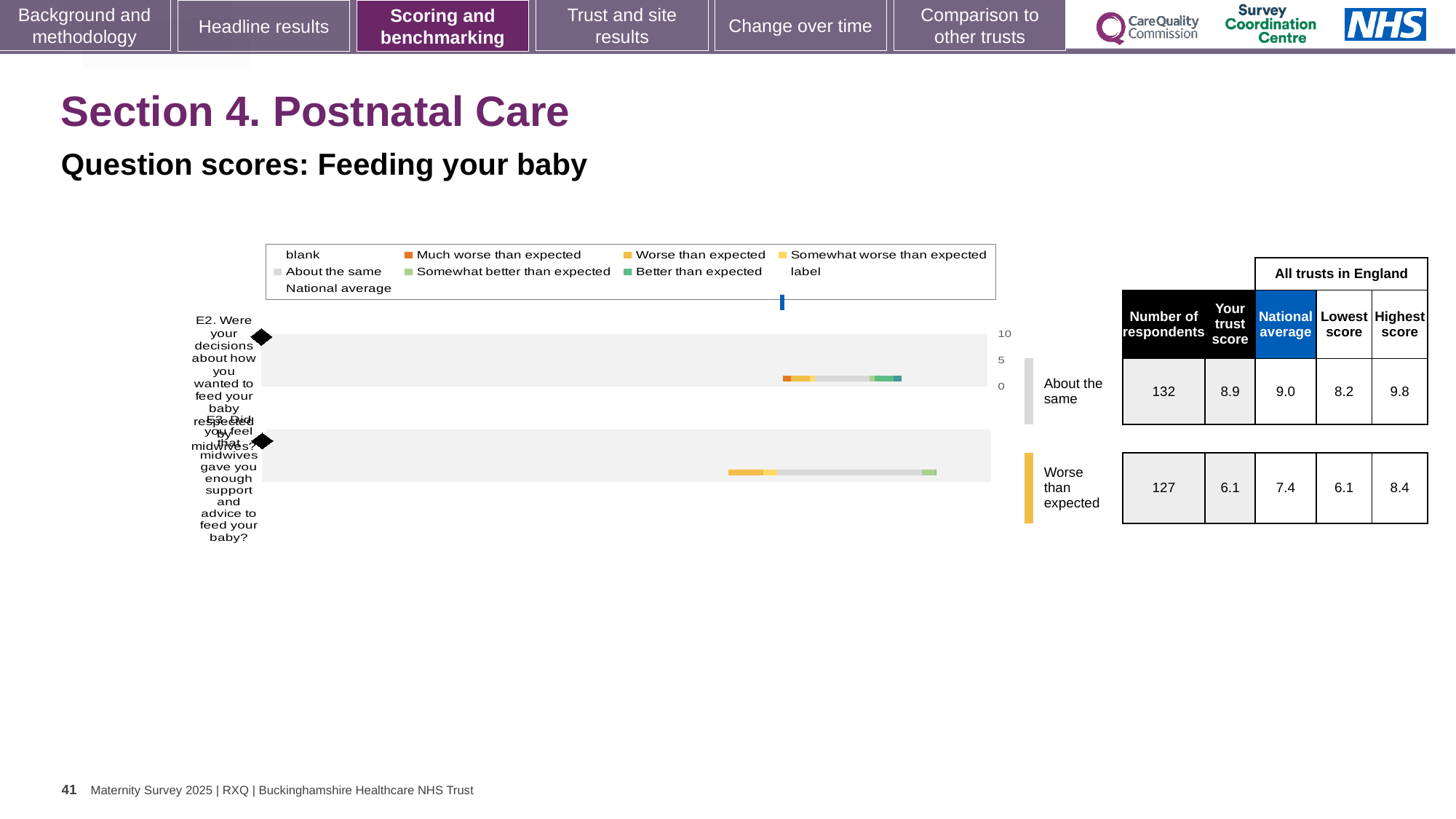
What is the highest score among all trusts in England for question E2? 9.8 Which question has the higher trust score, E2 or E3? E2 How many questions (categories) are plotted in the chart? 2 What is the lowest score among all trusts in England for question E3? 6.1 Which benchmark category is question E3 placed in? Worse than expected What kind of chart is shown on the slide for the feeding your baby question scores? bar chart What is the difference between the highest and lowest scores for question E2 across all trusts in England? 1.6 Which benchmark category is question E2 placed in? About the same How many respondents answered question E3? 127 What is the national average for question E3 about midwives giving enough support and advice to feed your baby? 7.4 What is the difference between the trust score and the national average for question E3? 1.3 What is the trust score for question E2 about decisions on how you wanted to feed your baby being respected by midwives? 8.9